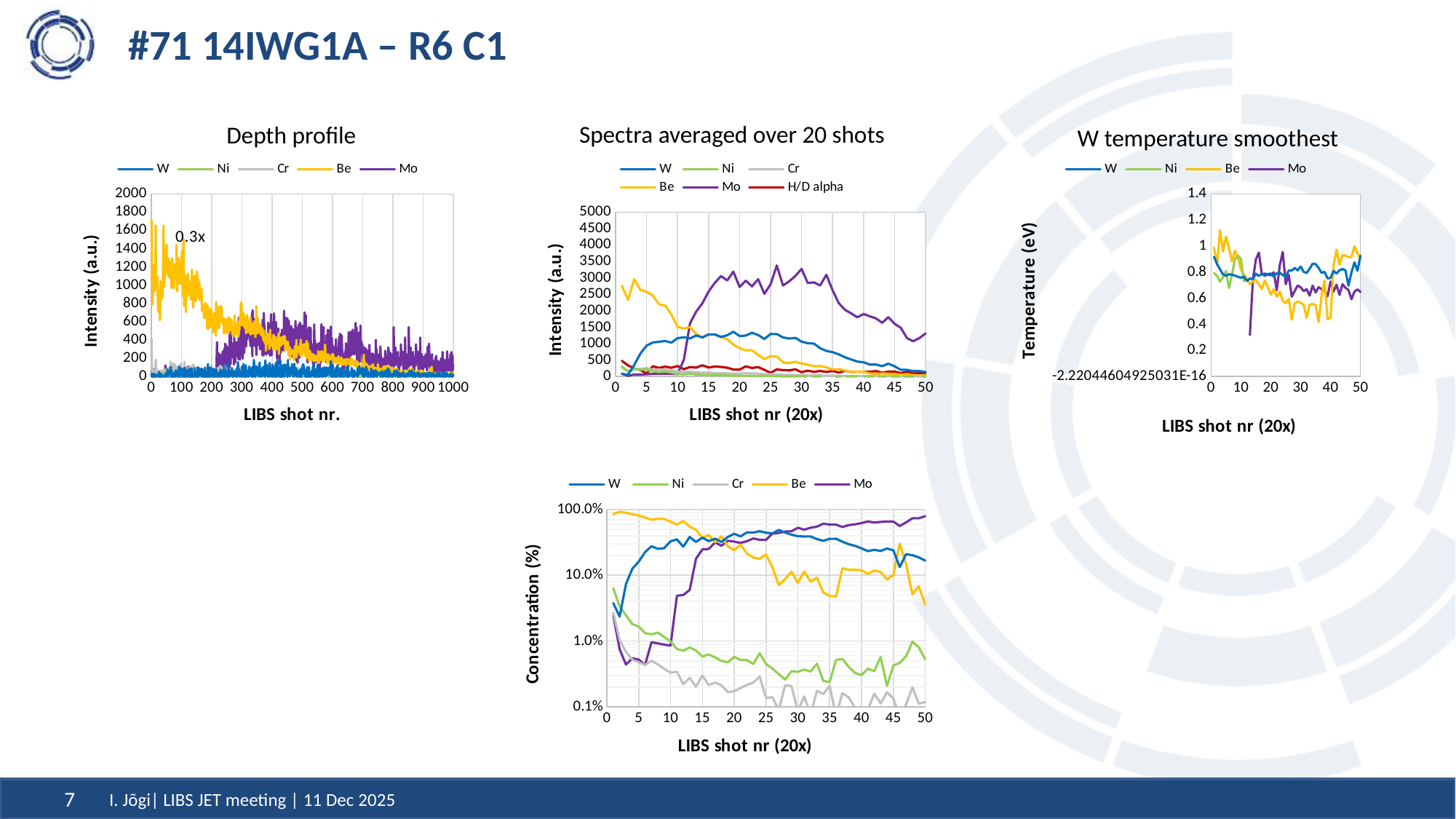
In the "Spectra averaged over 20 shots" chart, which is larger at LIBS shot nr 30, W or Mo? Mo What kind of chart is the "Depth profile" chart? line chart In the "Depth profile" chart, does the Be intensity rise or fall as the LIBS shot nr increases? fall How many series does the legend of the "W temperature smoothest" chart list? 4 How many series does the legend of the "Spectra averaged over 20 shots" chart list? 6 In the bottom-middle concentration chart, which series has the highest concentration at LIBS shot nr 45? Mo In the "Spectra averaged over 20 shots" chart, which series reaches the highest intensity? Mo How many series does the legend of the "Depth profile" chart list? 5 In the "Spectra averaged over 20 shots" chart, is the Be value at LIBS shot nr 40 greater or less than 500? less What is the x-axis label of the "Depth profile" chart? LIBS shot nr. In the "Spectra averaged over 20 shots" chart, is the Mo value at LIBS shot nr 25 greater or less than 2500? greater